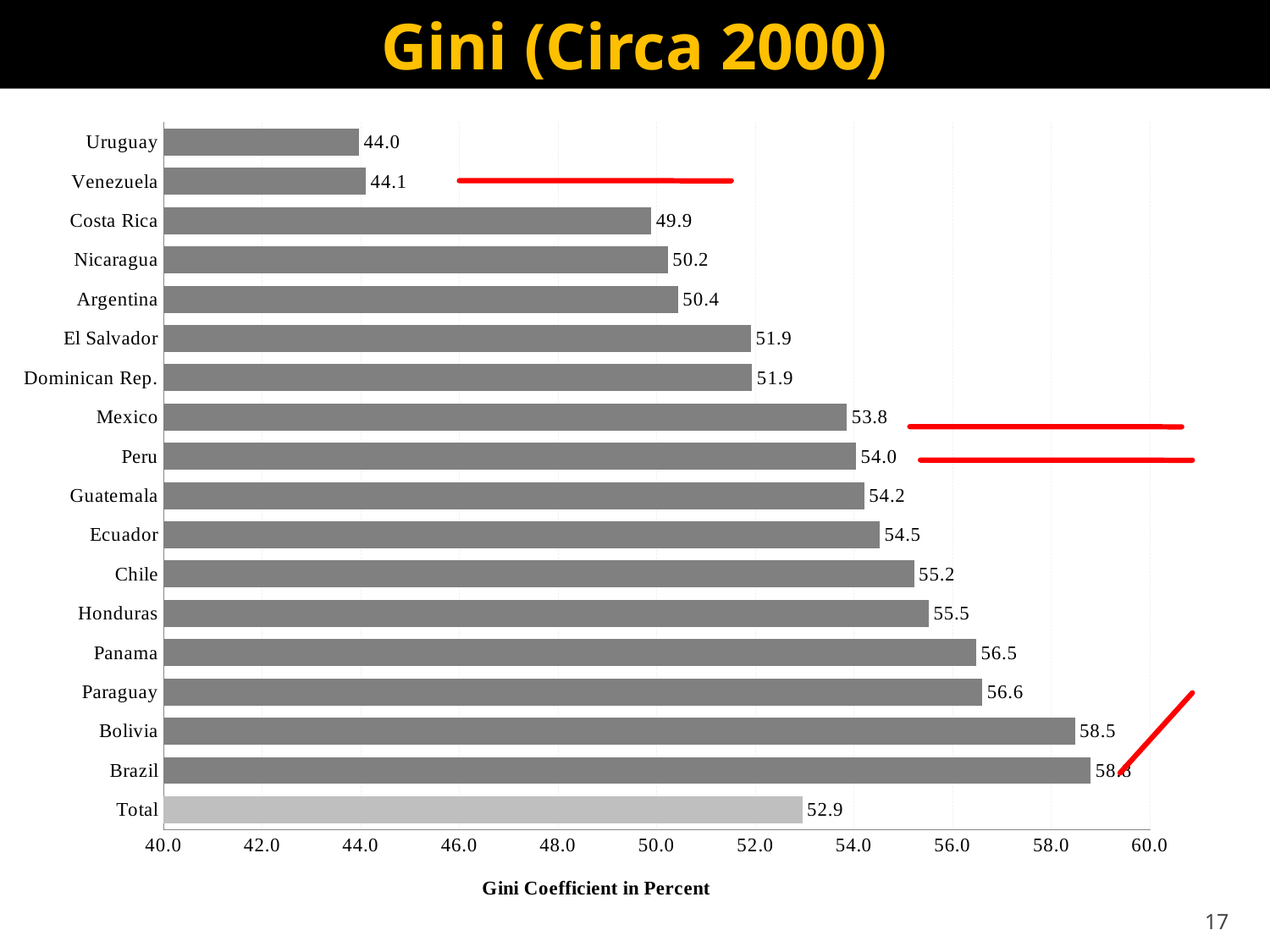
How many bars are shown on the chart, including the Total bar? 18 What is the value of the Total bar? 52.9 What is the Gini coefficient shown for Uruguay? 44.0 What is the title of the chart? Gini (Circa 2000) What is the difference between the Gini coefficients of Bolivia and Uruguay? 14.5 What is the Gini coefficient shown for Bolivia? 58.5 What kind of chart is shown on the slide? Bar chart Is the value for Paraguay greater or less than 56.0? greater Which has a higher Gini coefficient, Chile or Costa Rica? Chile What is the Gini coefficient shown for Mexico? 53.8 Which country has the lowest Gini coefficient on the chart? Uruguay Which country has the highest Gini coefficient on the chart? Brazil